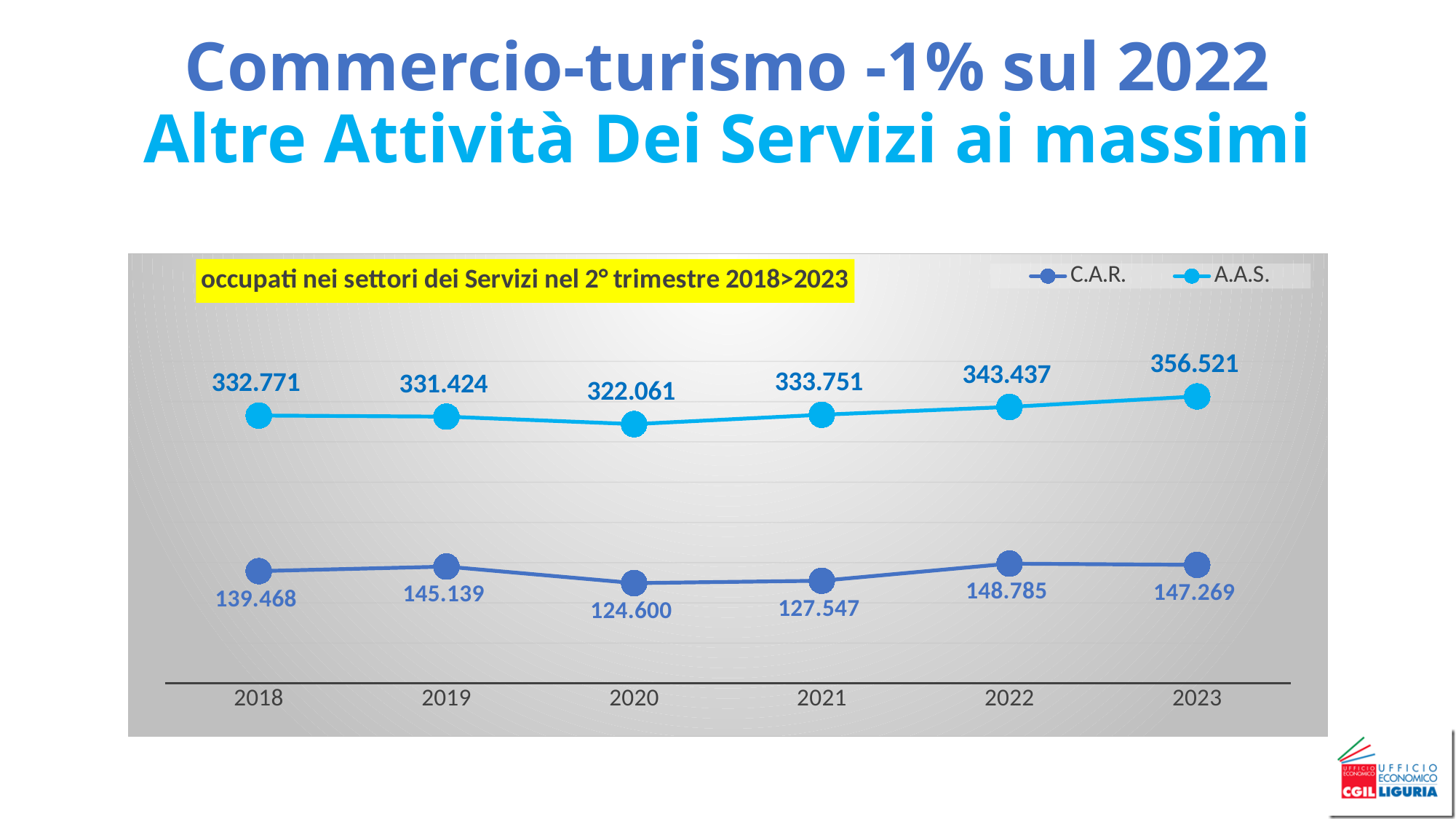
Which is larger, the C.A.R. value for 2022 or for 2023? 2022 In which year is the A.A.S. series at its lowest? 2020 What is the value for C.A.R. in 2022? 148.785 What type of chart is shown on the slide? Line chart What is the difference between the A.A.S. values for 2023 and 2022? 13.084 What is the difference between the C.A.R. values for 2019 and 2020? 20.539 How many series does the legend list? 2 What is the value for C.A.R. in 2020? 124.600 What is the value for A.A.S. in 2023? 356.521 How many years are plotted on the x axis? 6 In which year is the C.A.R. series at its highest? 2022 What is the title printed in the highlighted box inside the chart? occupati nei settori dei Servizi nel 2° trimestre 2018>2023